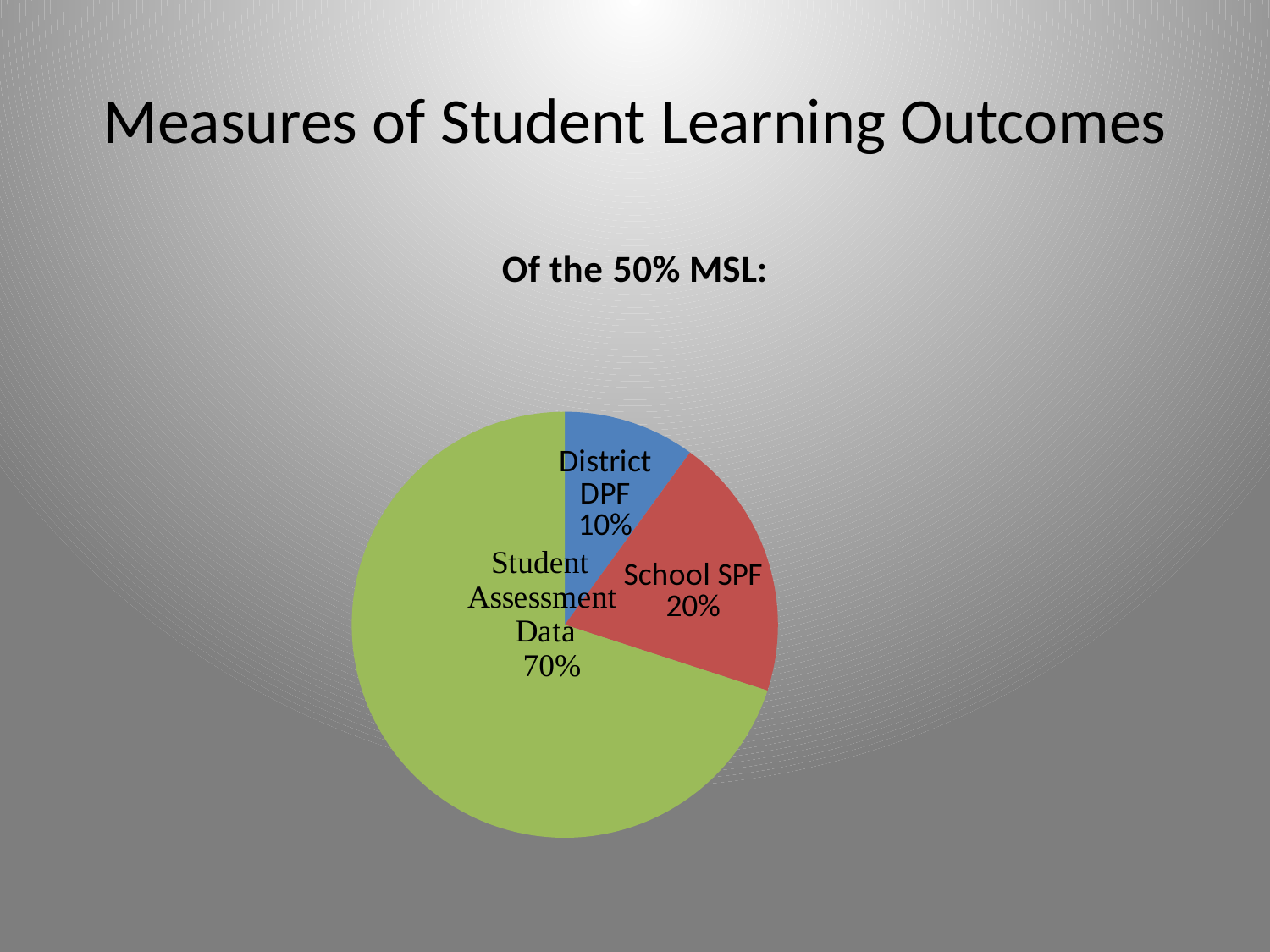
How many slices does the pie chart have? 3 What kind of chart is shown on the slide? pie chart What share of the pie does Student Assessment Data represent? 70% What is the difference in percentage points between School SPF and District DPF? 10 What colour is the Student Assessment Data slice? green Which is larger, the School SPF slice or the District DPF slice? School SPF What is the title of the chart? Of the 50% MSL: What share of the pie does District DPF represent? 10% What is the difference in percentage points between Student Assessment Data and School SPF? 50 Which slice of the pie is the smallest? District DPF What share of the pie does School SPF represent? 20% Which slice of the pie is the largest? Student Assessment Data